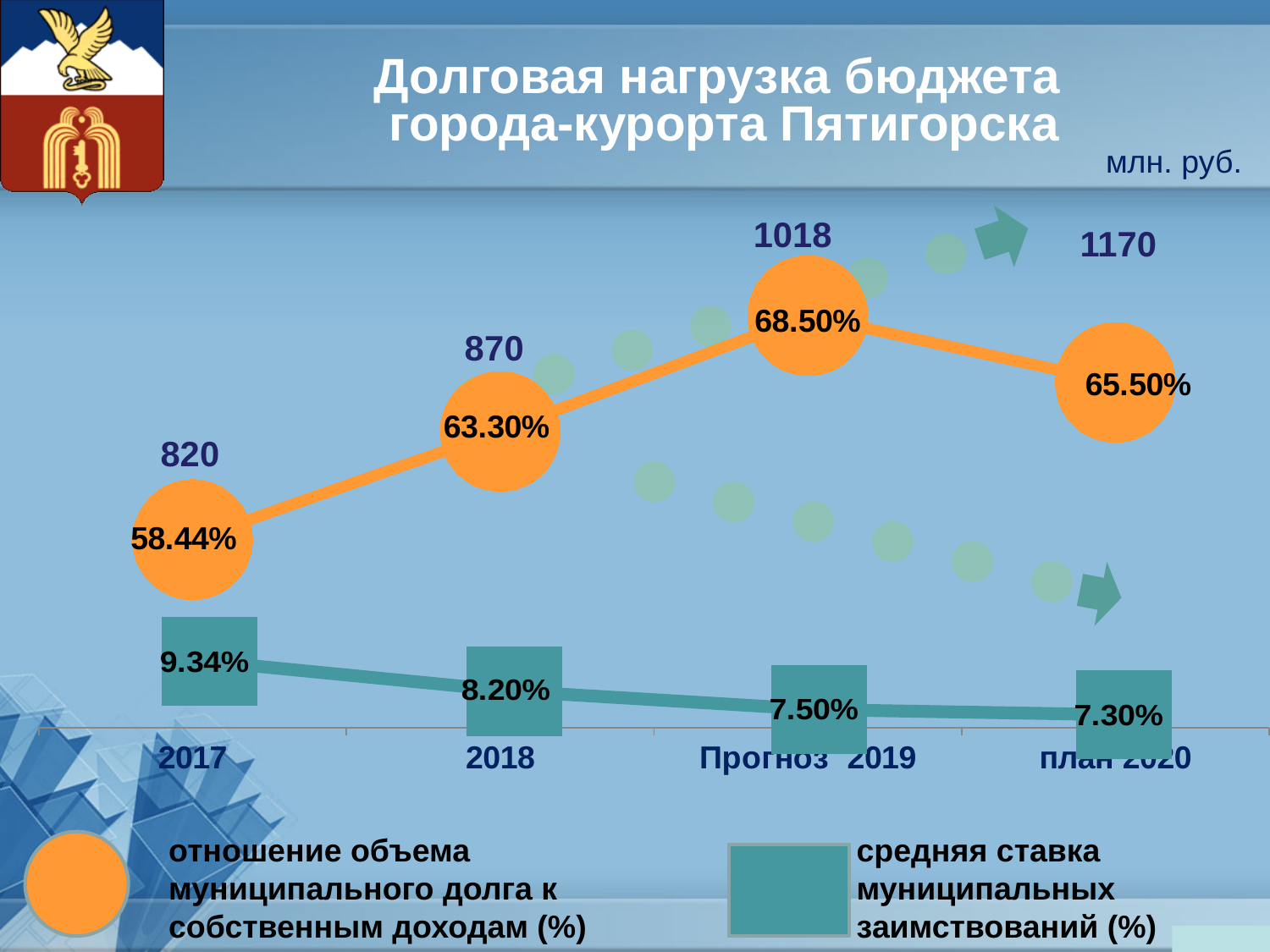
In which year is the ratio of municipal debt to own revenues highest? Прогноз 2019 What is the ratio of municipal debt to own revenues for 2017? 58.44% Which is larger: the average borrowing rate for 2017 or for Прогноз 2019? 2017 How many categories are shown on the x axis? 4 What is the average rate of municipal borrowings for план 2020? 7.30% In which year is the average rate of municipal borrowings lowest? план 2020 What is the ratio of municipal debt to own revenues for Прогноз 2019? 68.50% Does the average rate of municipal borrowings rise or fall from 2017 to план 2020? fall How many series does the legend list? 2 What is the difference between the debt-to-revenue ratio for Прогноз 2019 and for 2017? 10.06% What is the debt volume in млн. руб. shown for 2018? 870 What is the average rate of municipal borrowings for 2018? 8.20%